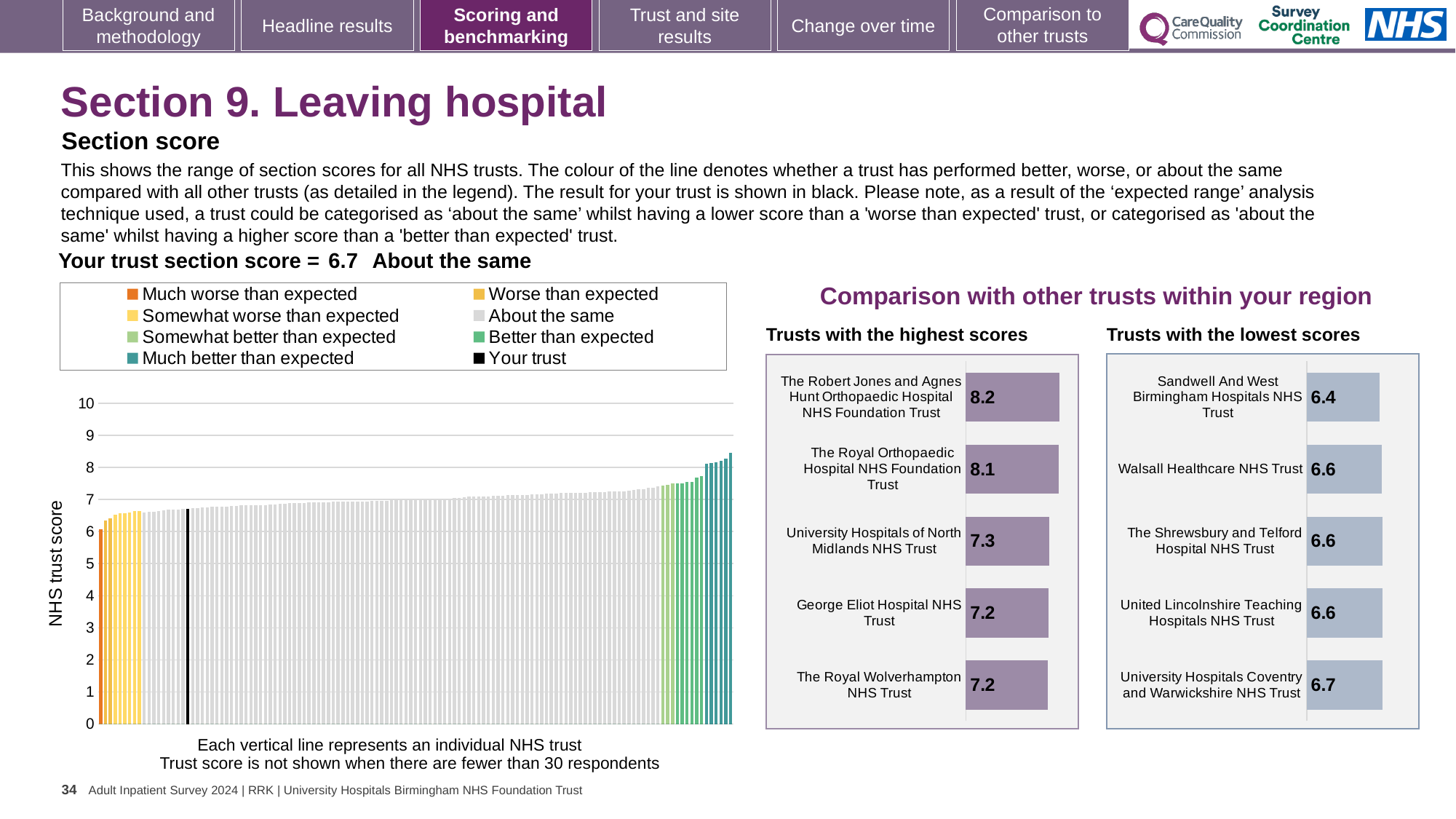
According to the slide, what is your trust's section score for Section 9, Leaving hospital? 6.7 How many entries does the legend above the large 'NHS trust score' chart list? 8 What kind of chart is the large 'NHS trust score' chart on the left of the slide? bar chart How many trusts are shown in the 'Trusts with the highest scores' chart? 5 In the 'Trusts with the lowest scores' chart, what is the score for Sandwell And West Birmingham Hospitals NHS Trust? 6.4 In the 'Trusts with the lowest scores' chart, what is the score for University Hospitals Coventry and Warwickshire NHS Trust? 6.7 In the 'Trusts with the highest scores' chart, what is the difference between the scores of The Robert Jones and Agnes Hunt Orthopaedic Hospital NHS Foundation Trust and The Royal Wolverhampton NHS Trust? 1.0 In the 'Trusts with the highest scores' chart, what is the score for The Robert Jones and Agnes Hunt Orthopaedic Hospital NHS Foundation Trust? 8.2 In the 'Trusts with the highest scores' chart, which has the higher score: The Royal Orthopaedic Hospital NHS Foundation Trust or University Hospitals of North Midlands NHS Trust? The Royal Orthopaedic Hospital NHS Foundation Trust In the large 'NHS trust score' chart on the left, do the values rise or fall from left to right? rise In the 'Trusts with the highest scores' chart, which trust has the highest score? The Robert Jones and Agnes Hunt Orthopaedic Hospital NHS Foundation Trust In the 'Trusts with the lowest scores' chart, which trust has the lowest score? Sandwell And West Birmingham Hospitals NHS Trust